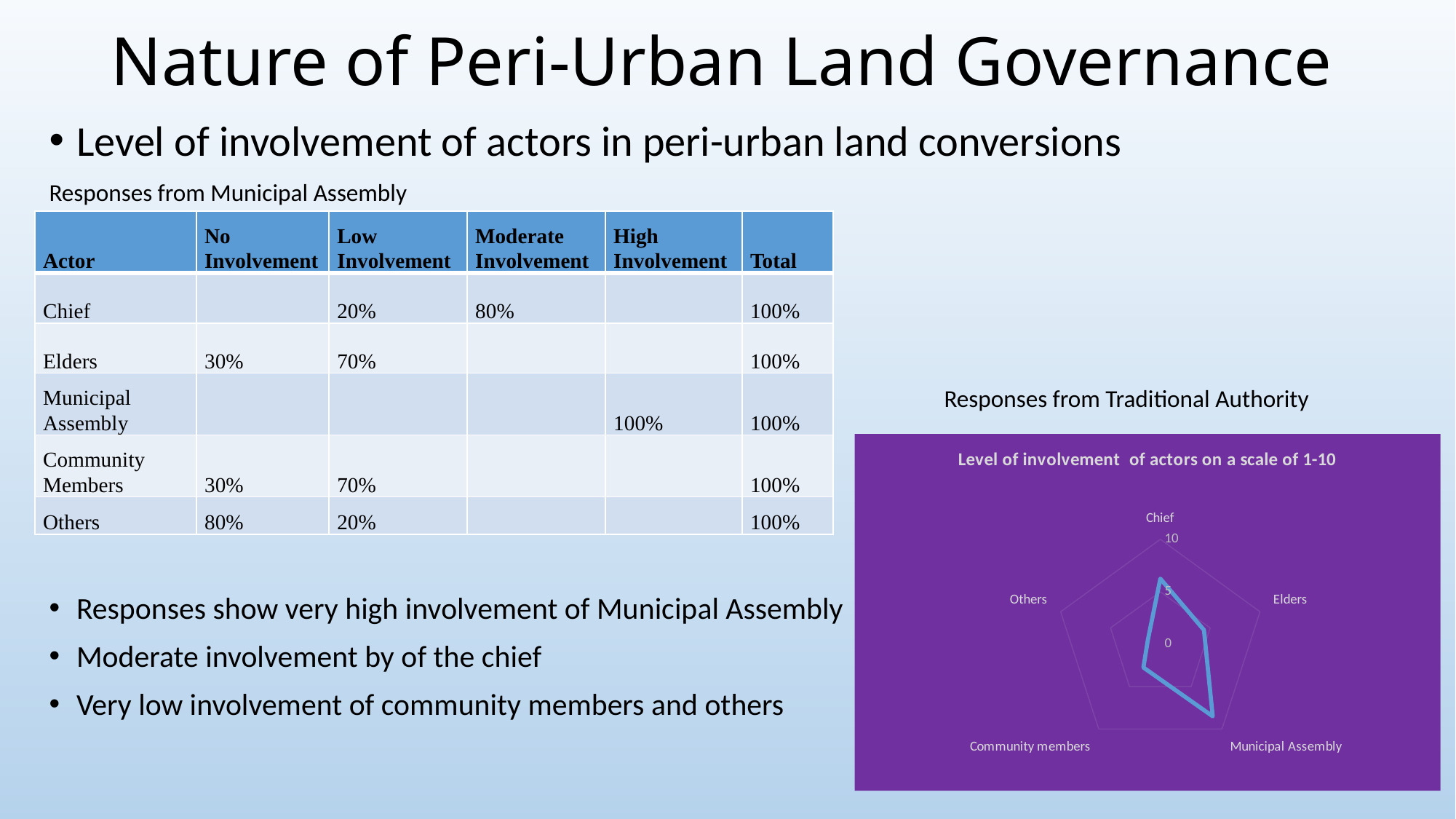
Is the value for Community members on the radar chart greater or less than 5? less What is the title of the radar chart? Level of involvement of actors on a scale of 1-10 On the radar chart, which has the larger value: Municipal Assembly or Elders? Municipal Assembly How many actors (categories) are plotted on the radar chart? 5 What kind of chart is shown on the slide? Radar chart On the radar chart, which has the larger value: Chief or Community members? Chief Is the value for Municipal Assembly on the radar chart greater or less than 5? greater On the radar chart, which has the larger value: Chief or Elders? Chief Which actor has the highest level of involvement on the radar chart? Municipal Assembly Is the value for Elders on the radar chart greater or less than 5? less What is the maximum value shown on the radar chart's scale? 10